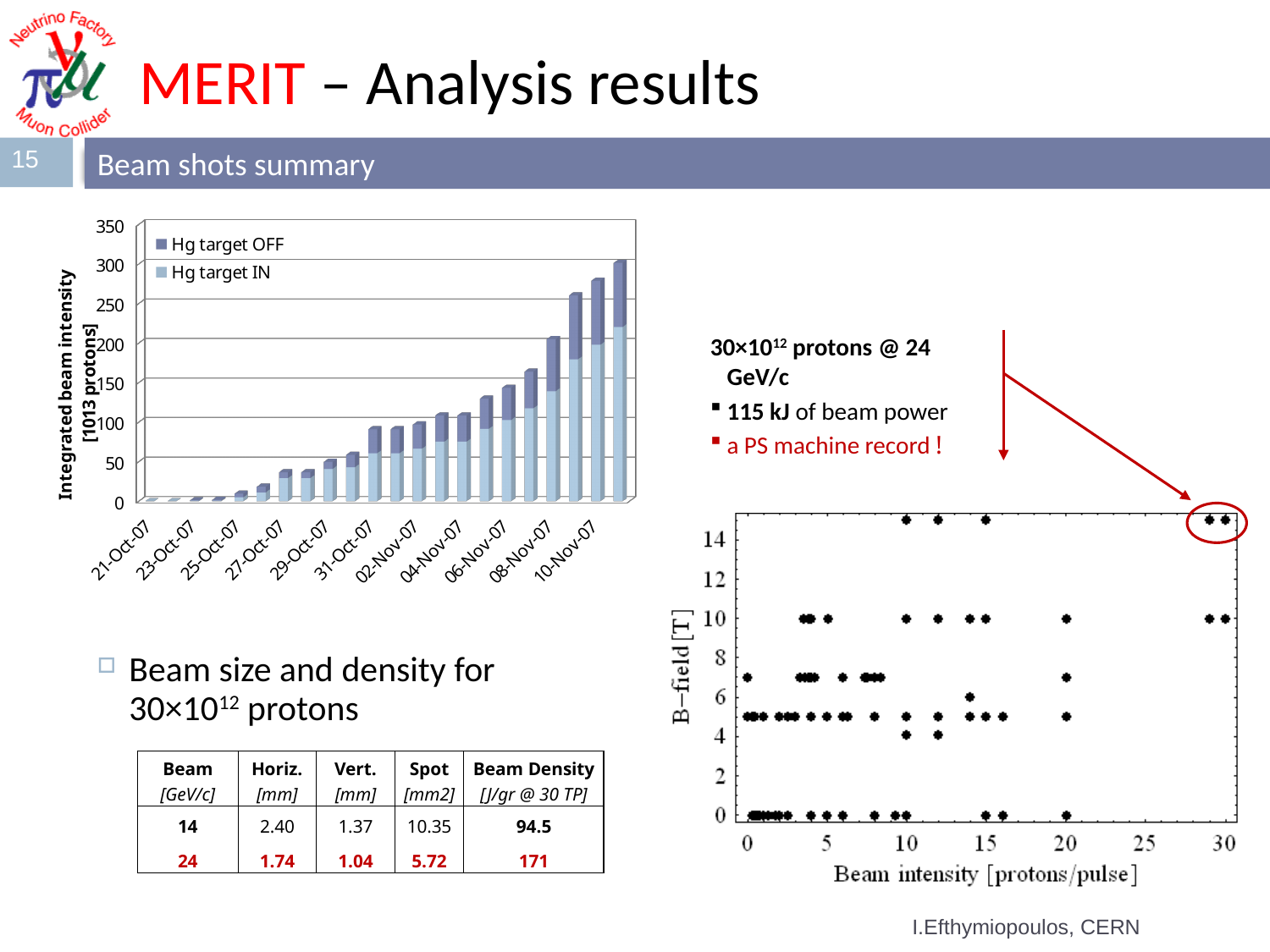
What kind of chart is the 'Integrated beam intensity' chart on the left of the slide? Stacked bar chart How many series does the legend of the left bar chart list? 2 What is the maximum value shown on the y axis of the left bar chart? 350 In the left bar chart, is the total of the bar for 21-Oct-07 greater or less than 50? less In the left bar chart, is the total of the rightmost bar greater or less than 250? greater What are the two legend entries of the left bar chart? Hg target OFF and Hg target IN In the right scatter chart, are the highest B-field points greater or less than 14 T? greater What kind of chart is the 'B-field' versus 'Beam intensity' chart on the right of the slide? Scatter chart In the right scatter chart, what is the largest tick value shown on the x axis? 30 In the left bar chart, do the integrated beam intensity values rise or fall from left to right along the date axis? Rise